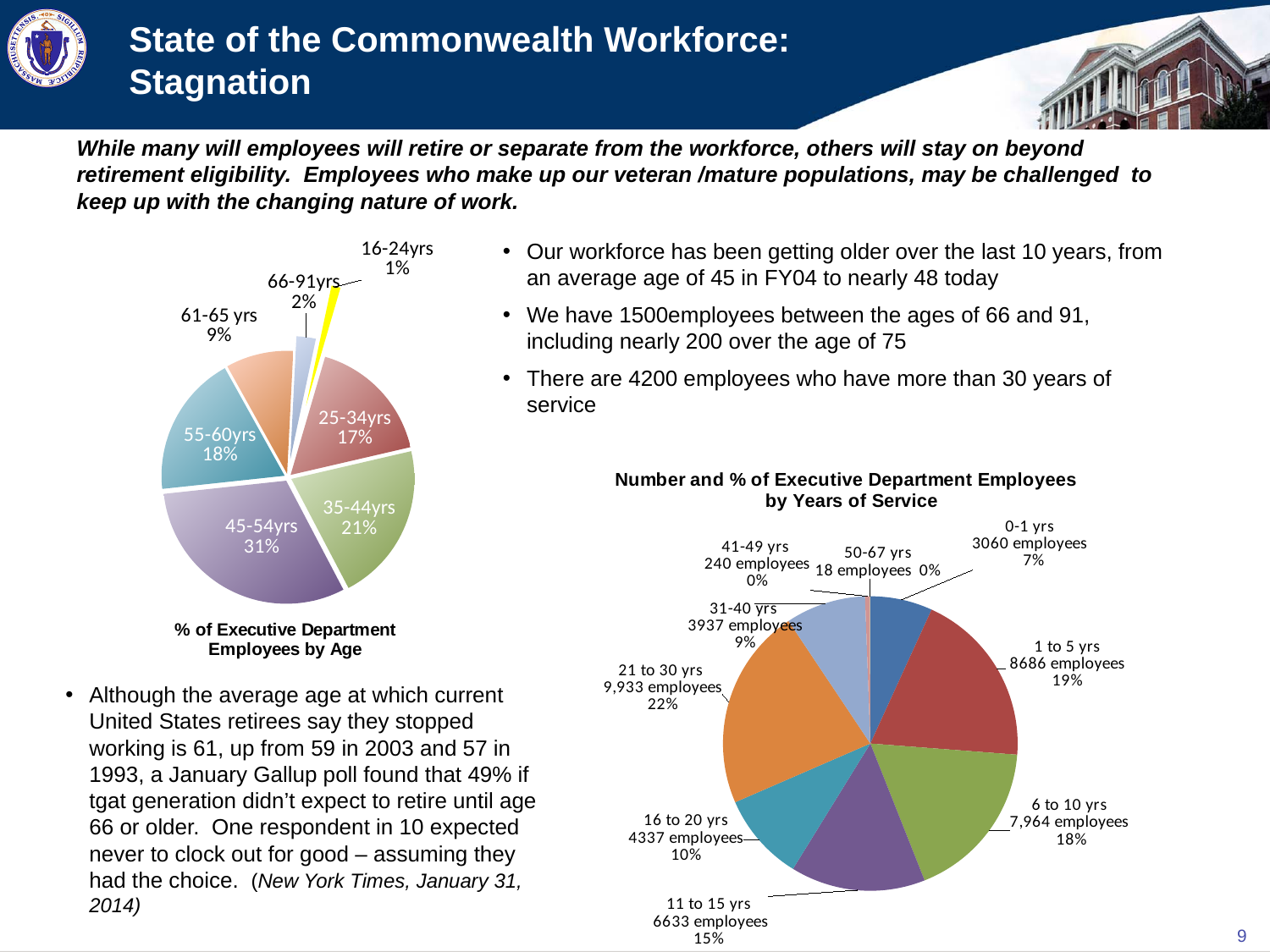
In the '% of Executive Department Employees by Age' chart, which age group has the smallest share? 16-24yrs In the 'Number and % of Executive Department Employees by Years of Service' chart, how many employees have 21 to 30 years of service? 9,933 employees In the '% of Executive Department Employees by Age' chart, what is the difference in percentage points between the 35-44yrs and 25-34yrs slices? 4 In the '% of Executive Department Employees by Age' chart, which age group has the largest share? 45-54yrs In the '% of Executive Department Employees by Age' chart, what share of employees are aged 45-54? 31% In the '% of Executive Department Employees by Age' chart, how many age groups are shown? 7 What type of chart is the '% of Executive Department Employees by Age' chart? Pie chart In the 'Number and % of Executive Department Employees by Years of Service' chart, which group has more employees: 6 to 10 yrs or 11 to 15 yrs? 6 to 10 yrs In the 'Number and % of Executive Department Employees by Years of Service' chart, which years-of-service group has the fewest employees? 50-67 yrs In the 'Number and % of Executive Department Employees by Years of Service' chart, what percentage of employees have 1 to 5 years of service? 19% In the 'Number and % of Executive Department Employees by Years of Service' chart, which years-of-service group has the most employees? 21 to 30 yrs In the 'Number and % of Executive Department Employees by Years of Service' chart, how many years-of-service categories are shown? 9